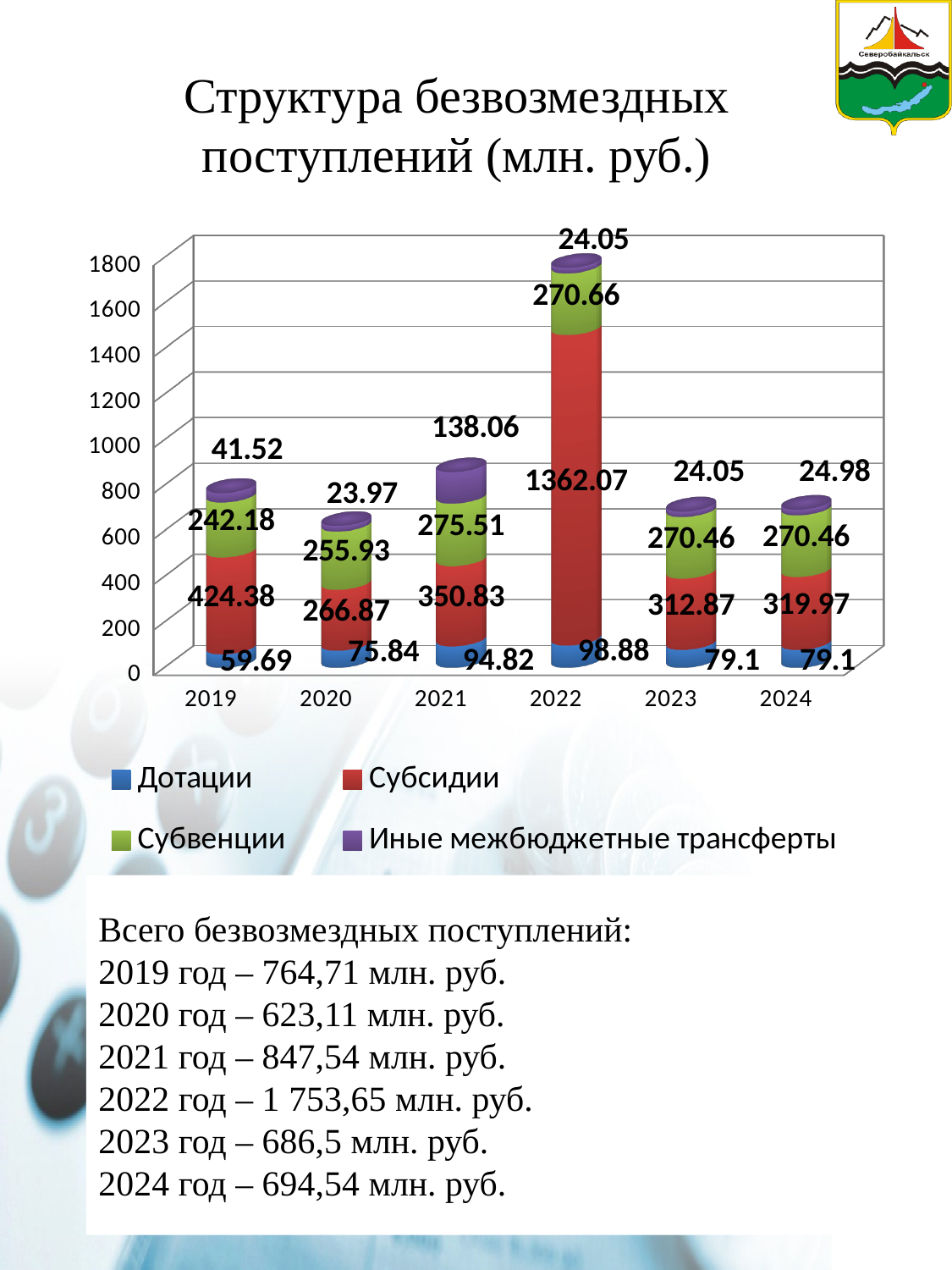
How many series does the legend list? 4 What type of chart is shown on the slide? stacked bar chart In which year is the value of Субсидии the highest? 2022 How many years are shown on the x axis of the chart? 6 What is the value of Субвенции for 2023? 270.46 Which year has the larger value of Субвенции, 2019 or 2021? 2021 Is the total height of the stacked bar for 2022 greater or less than 1600? greater What is the value of Субсидии for 2022? 1362.07 In which year is the value of Дотации the lowest? 2019 What is the value of Иные межбюджетные трансферты for 2021? 138.06 What is the difference between the Субсидии values for 2024 and 2023? 7.1 What is the value of Дотации for 2019? 59.69